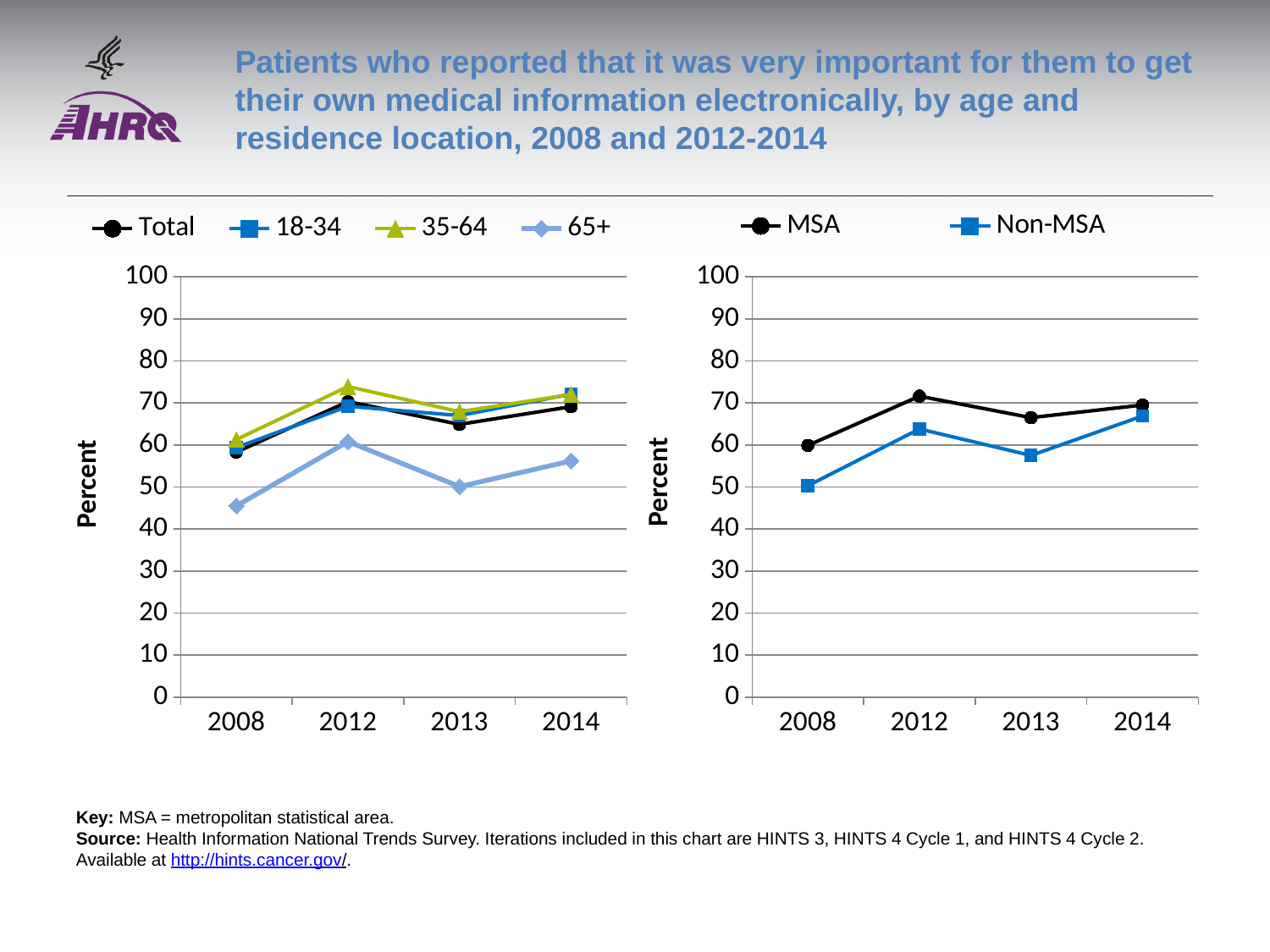
What kind of chart is the left chart (by age)? line chart How many series does the legend of the right chart (MSA vs Non-MSA) list? 2 In the left chart (by age), which series has the highest value in 2012? 35-64 How many series does the legend of the left chart (by age) list? 4 In the left chart (by age), which age group has the lowest value in 2013? 65+ In the left chart (by age), is the value for 65+ in 2012 greater or less than 70? less What is the label on the y axis of the left chart (by age)? Percent In the left chart (by age), is the value for 65+ in 2008 greater or less than 50? less In the right chart (MSA vs Non-MSA), does the Non-MSA line rise or fall from 2008 to 2012? rise In the right chart (MSA vs Non-MSA), which is larger in 2012, MSA or Non-MSA? MSA In the right chart (MSA vs Non-MSA), is the value for Non-MSA in 2008 greater or less than 60? less How many years are shown on the x axis of the right chart (MSA vs Non-MSA)? 4